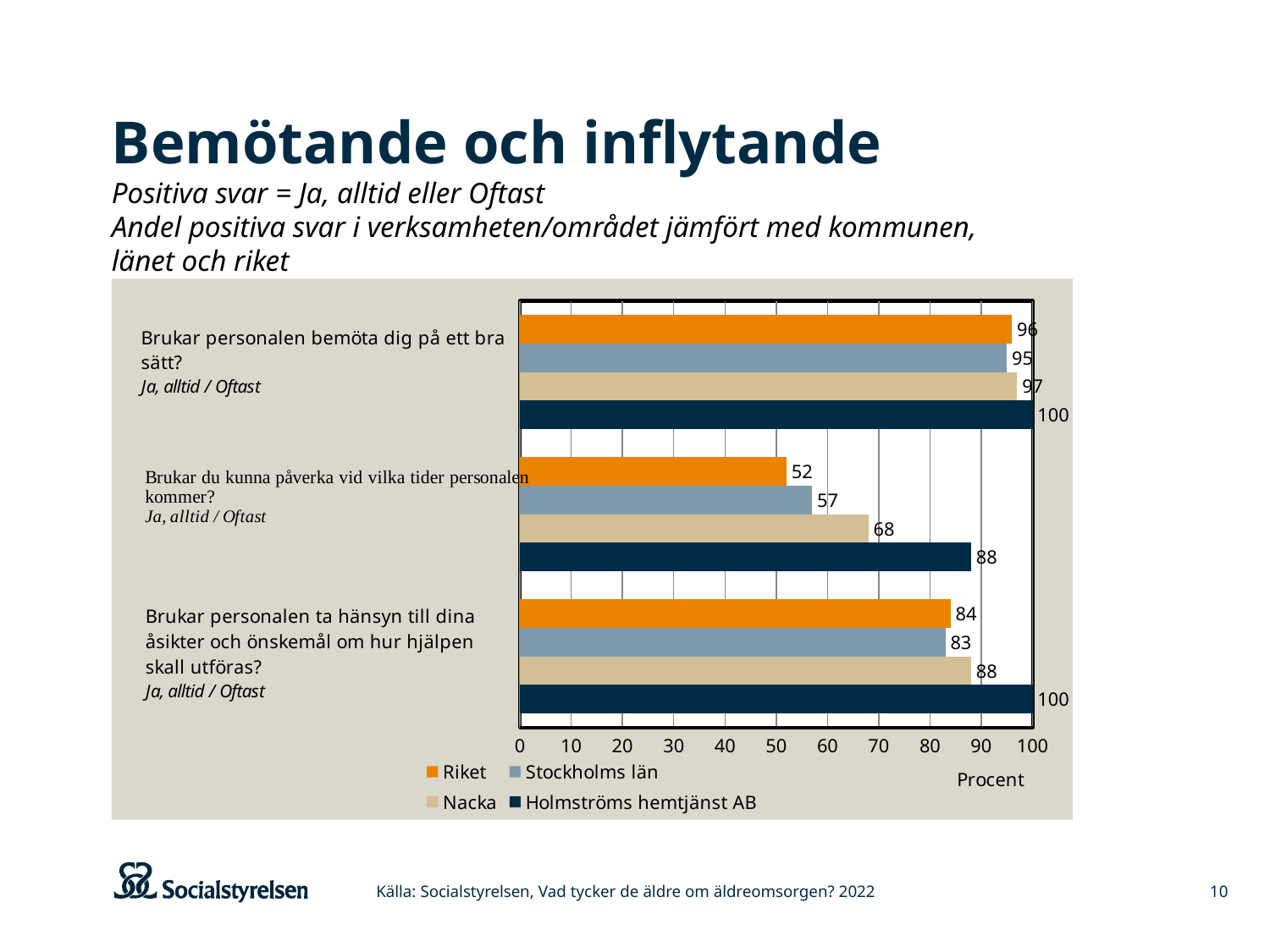
What is the difference between Holmströms hemtjänst AB and Riket for the question "Brukar du kunna påverka vid vilka tider personalen kommer?"? 36 What is the value for Stockholms län for the question "Brukar personalen bemöta dig på ett bra sätt?"? 95 What is the value for Riket for the question "Brukar du kunna påverka vid vilka tider personalen kommer?"? 52 What unit is shown on the x axis of the chart? Procent What kind of chart is shown on the slide? Bar chart Which series has the lowest value for the question "Brukar du kunna påverka vid vilka tider personalen kommer?"? Riket For the question "Brukar du kunna påverka vid vilka tider personalen kommer?", which is larger: Nacka or Stockholms län? Nacka Which series has the highest value for the question "Brukar personalen ta hänsyn till dina åsikter och önskemål om hur hjälpen skall utföras?"? Holmströms hemtjänst AB How many question categories are plotted on the chart? 3 What is the value for Nacka for the question "Brukar personalen ta hänsyn till dina åsikter och önskemål om hur hjälpen skall utföras?"? 88 What is the value for Holmströms hemtjänst AB for the question "Brukar du kunna påverka vid vilka tider personalen kommer?"? 88 How many series does the legend list? 4